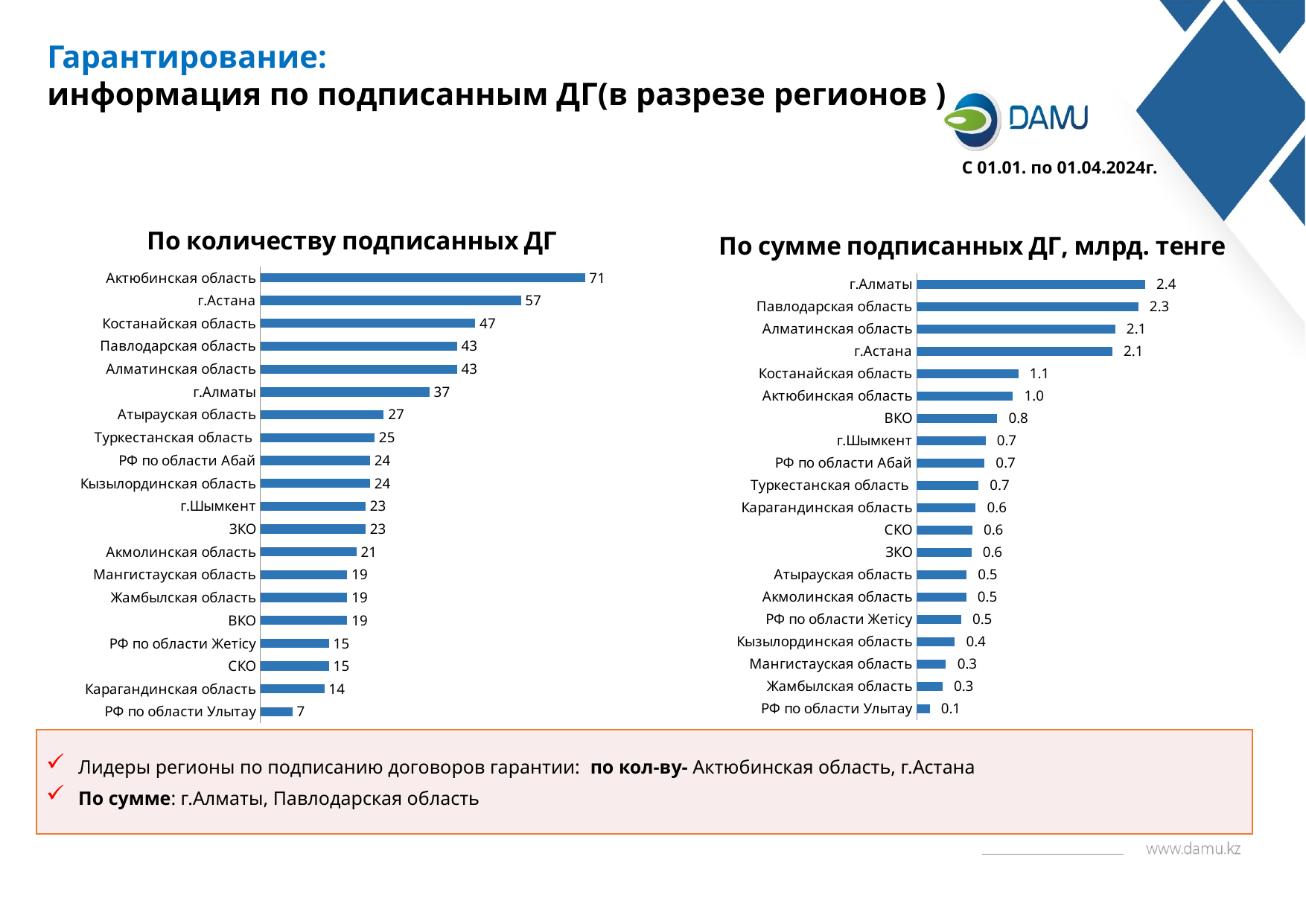
In the chart 'По сумме подписанных ДГ, млрд. тенге', which region has the highest value? г.Алматы In the chart 'По сумме подписанных ДГ, млрд. тенге', which is larger: Костанайская область or ВКО? Костанайская область In the chart 'По сумме подписанных ДГ, млрд. тенге', what is the value for Павлодарская область? 2.3 In the chart 'По количеству подписанных ДГ', what is the difference between Актюбинская область and г.Астана? 14 In the chart 'По количеству подписанных ДГ', which region has the highest value? Актюбинская область In the chart 'По количеству подписанных ДГ', what is the value for Костанайская область? 47 In the chart 'По количеству подписанных ДГ', what is the value for г.Шымкент? 23 In the chart 'По сумме подписанных ДГ, млрд. тенге', what is the difference between г.Алматы and Актюбинская область? 1.4 In the chart 'По сумме подписанных ДГ, млрд. тенге', which region has the lowest value? РФ по области Улытау What type of chart is 'По количеству подписанных ДГ'? Bar chart In the chart 'По количеству подписанных ДГ', how many regions are shown? 20 In the chart 'По количеству подписанных ДГ', which region has the lowest value? РФ по области Улытау